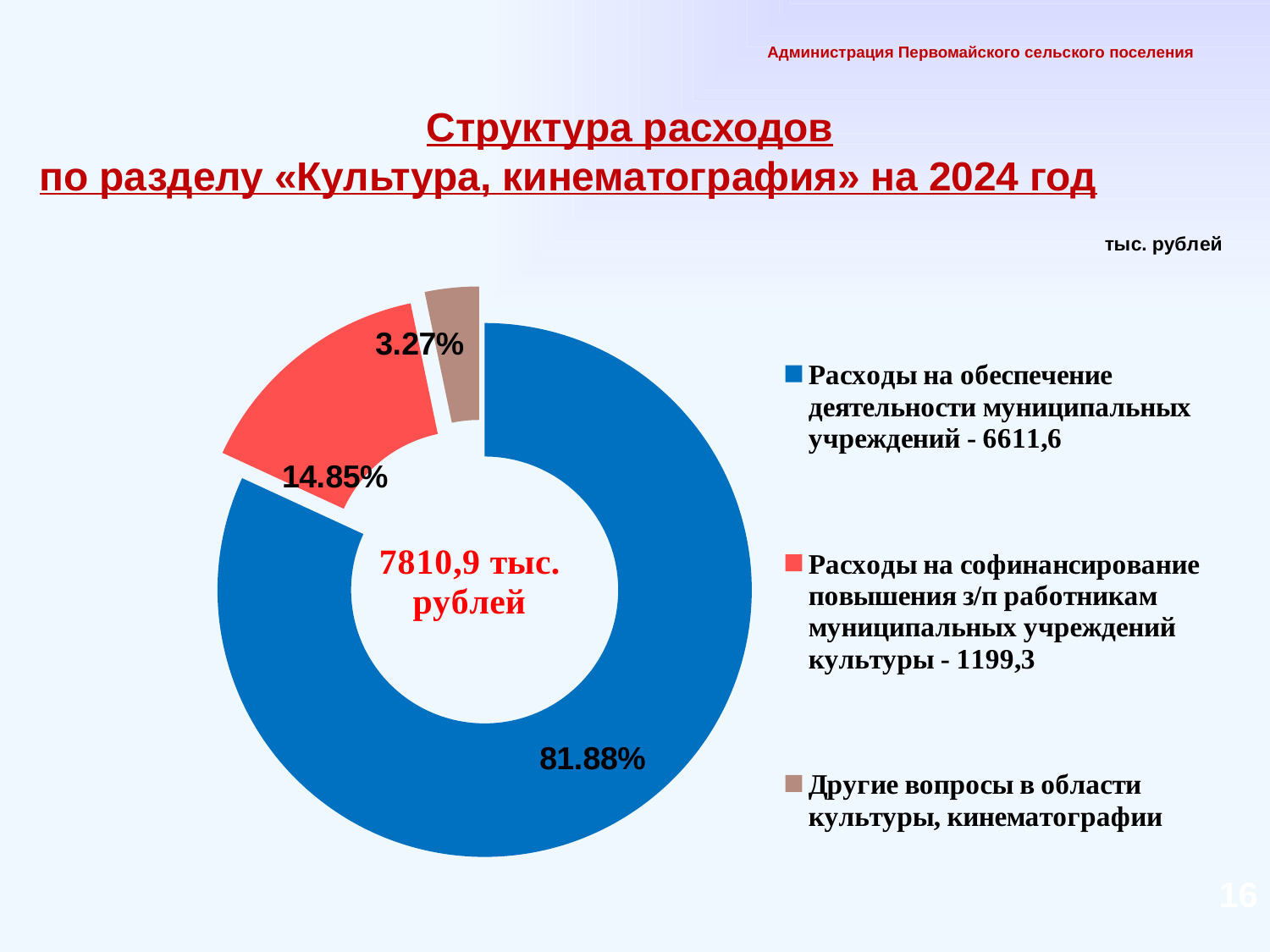
What kind of chart is shown on the slide? Pie (doughnut) chart What total amount is shown in the centre of the doughnut chart? 7810,9 тыс. рублей What colour is the slice for «Другие вопросы в области культуры, кинематографии»? Brown (grey-brown) What amount (in тыс. рублей) is given in the legend for «Расходы на обеспечение деятельности муниципальных учреждений»? 6611,6 What share of the pie does the slice for «Другие вопросы в области культуры, кинематографии» represent? 3.27% Which category has the largest slice of the pie? Расходы на обеспечение деятельности муниципальных учреждений Which category has the smallest slice of the pie? Другие вопросы в области культуры, кинематографии What share of the pie does the slice for «Расходы на софинансирование повышения з/п работникам муниципальных учреждений культуры» represent? 14.85% What is the difference in percentage points between the largest slice (81.88%) and the second largest slice (14.85%)? 67.03% Which slice is larger: «Расходы на софинансирование повышения з/п работникам муниципальных учреждений культуры» or «Другие вопросы в области культуры, кинематографии»? Расходы на софинансирование повышения з/п работникам муниципальных учреждений культуры What share of the pie does the slice for «Расходы на обеспечение деятельности муниципальных учреждений» represent? 81.88% How many slices does the pie chart have? 3